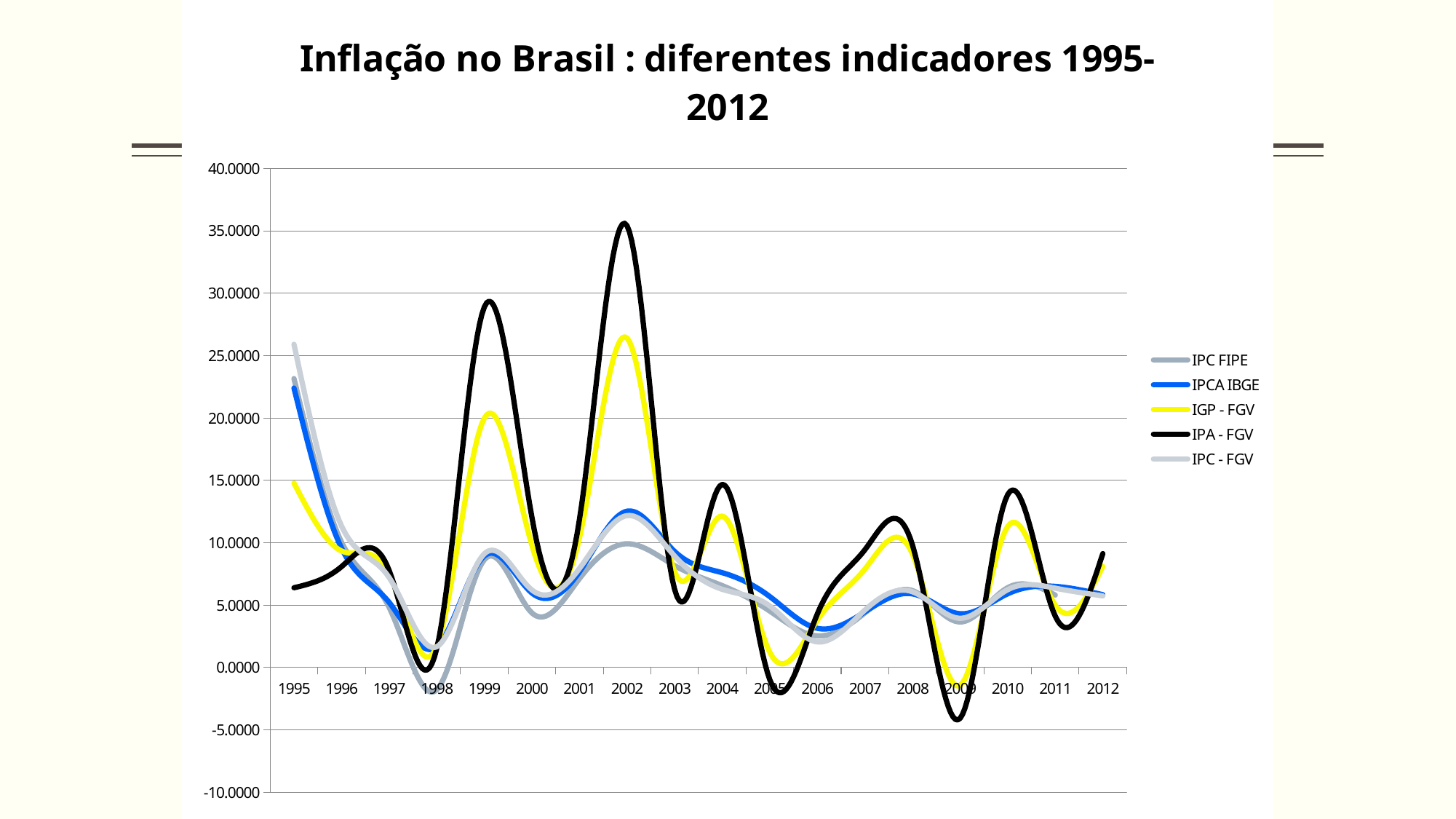
In 2002, which is larger: IPA - FGV or IPCA IBGE? IPA - FGV Which series is drawn in yellow? IGP - FGV Is the value for IPA - FGV in 1995 greater or less than 10.0000? less In which year does the IGP - FGV series reach its highest value? 2002 Is the value for IPA - FGV in 2002 greater or less than 30.0000? greater How many years are shown on the x axis? 18 Does the IPCA IBGE series rise or fall from 1995 to 1998? fall Is the value for IPA - FGV in 2009 greater or less than 0.0000? less What is the title of the chart? Inflação no Brasil : diferentes indicadores 1995-2012 In which year does the IPA - FGV series reach its highest value? 2002 What kind of chart is shown on the slide? line chart How many series does the legend list? 5